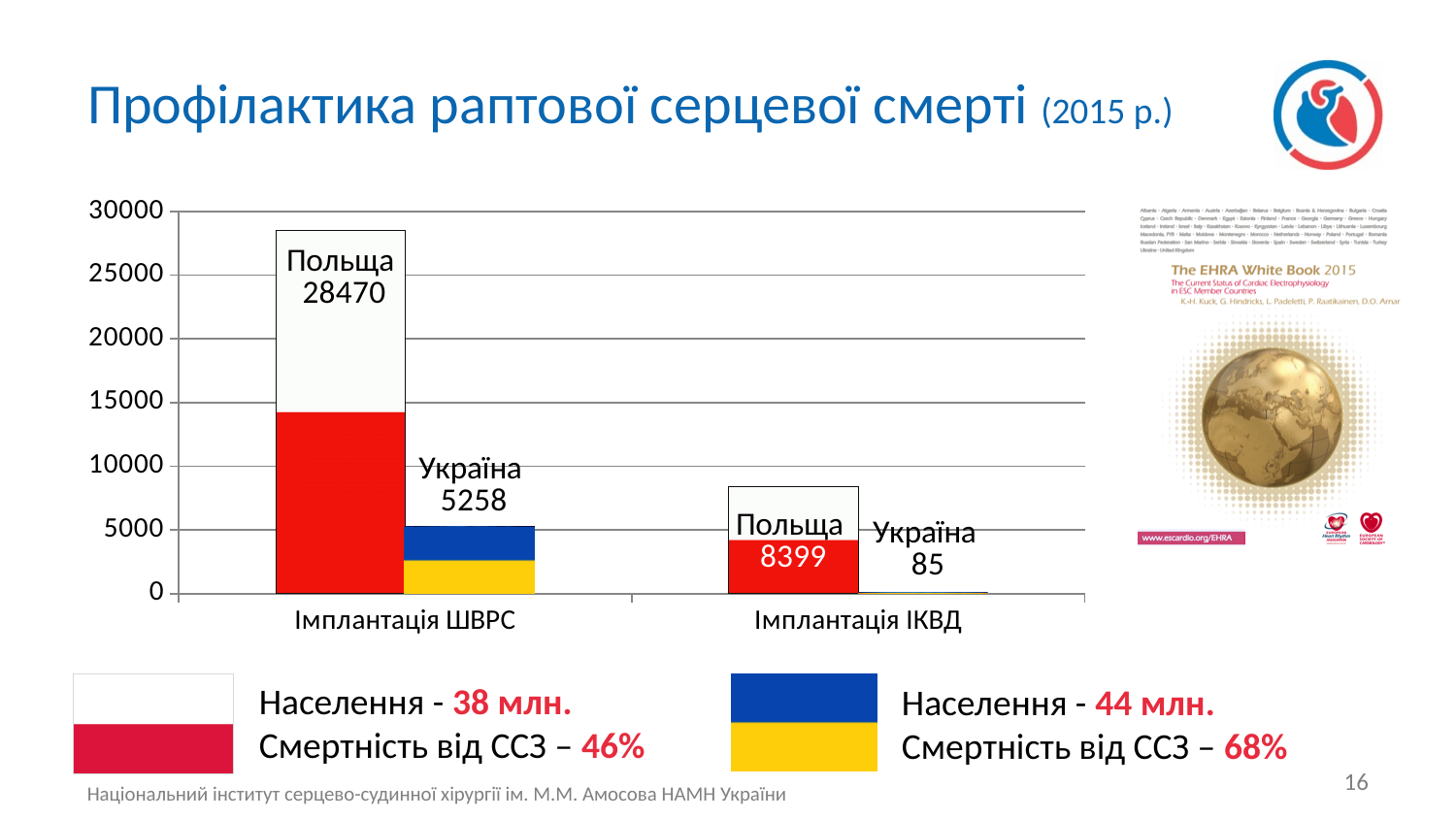
How many categories are shown on the x axis of the chart? 2 Which is larger: the Україна value for Імплантація ШВРС or the Польща value for Імплантація ІКВД? Польща value for Імплантація ІКВД What is the difference between the Польща and Україна values in the Імплантація ШВРС category? 23212 Which bar has the lowest value on the chart? Україна, Імплантація ІКВД What is the value for Польща in the Імплантація ІКВД category? 8399 What is the value for Україна in the Імплантація ШВРС category? 5258 What is the value for Україна in the Імплантація ІКВД category? 85 What type of chart is shown on the slide? bar chart What is the value for Польща in the Імплантація ШВРС category? 28470 Which bar has the highest value on the chart? Польща, Імплантація ШВРС What is the difference between the Польща and Україна values in the Імплантація ІКВД category? 8314 Is the value for Польща in the Імплантація ШВРС category greater or less than 25000? greater